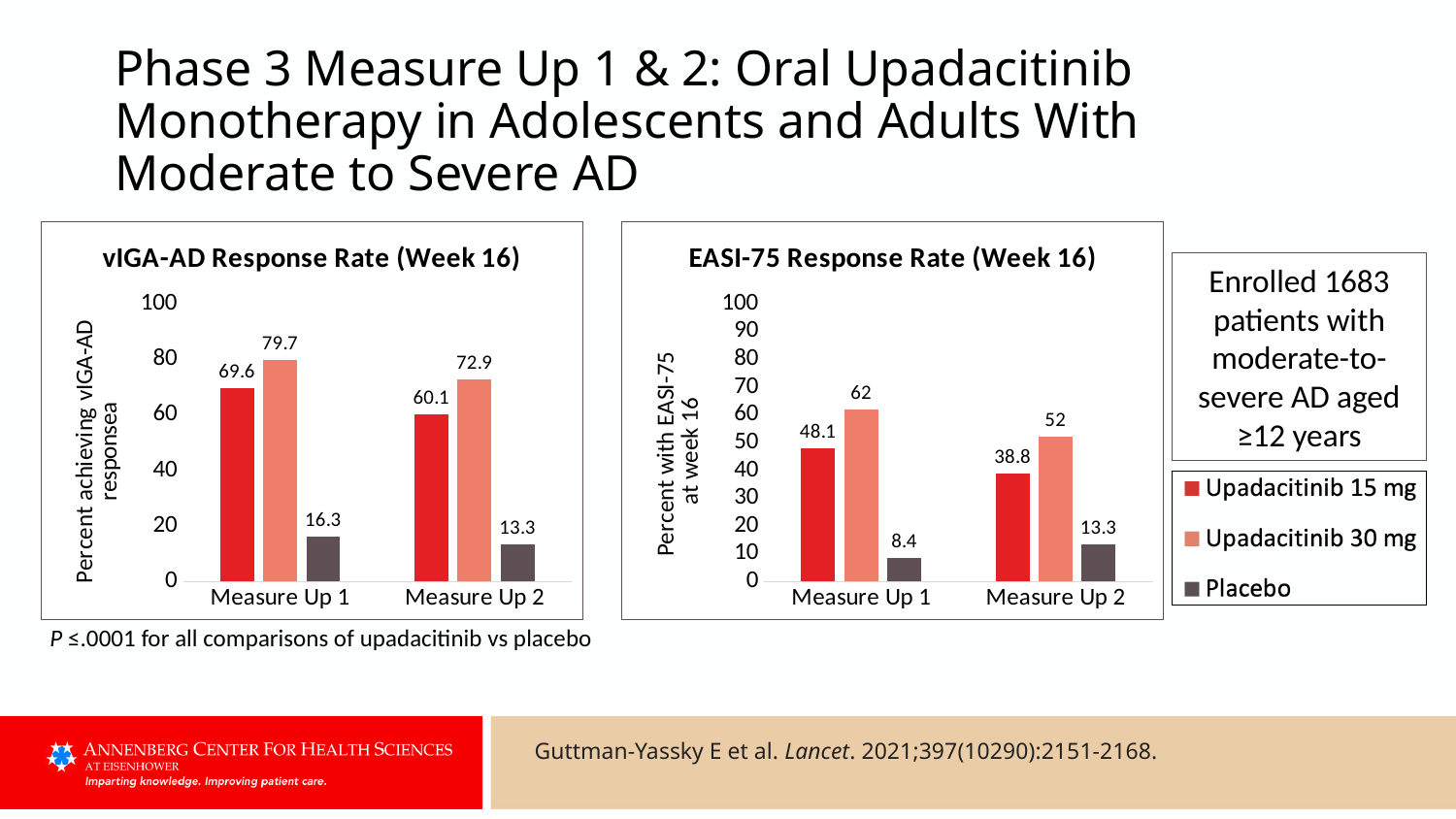
In the EASI-75 Response Rate (Week 16) chart, which series has the lowest value in Measure Up 2? Placebo In the EASI-75 Response Rate (Week 16) chart, what is the value for Placebo in Measure Up 1? 8.4 How many series does the legend list? 3 In the EASI-75 Response Rate (Week 16) chart, what is the difference between Upadacitinib 30 mg and Placebo in Measure Up 1? 53.6 In the EASI-75 Response Rate (Week 16) chart, what is the value for Upadacitinib 15 mg in Measure Up 2? 38.8 How many categories are shown on the x axis of the EASI-75 Response Rate (Week 16) chart? 2 In the vIGA-AD Response Rate (Week 16) chart, what is the value for Upadacitinib 30 mg in Measure Up 1? 79.7 What kind of chart is the vIGA-AD Response Rate (Week 16) chart? Bar chart In the vIGA-AD Response Rate (Week 16) chart, what is the difference between Upadacitinib 30 mg and Upadacitinib 15 mg in Measure Up 2? 12.8 In the EASI-75 Response Rate (Week 16) chart, which is larger: Upadacitinib 15 mg in Measure Up 1 or Upadacitinib 30 mg in Measure Up 2? Upadacitinib 30 mg in Measure Up 2 In the vIGA-AD Response Rate (Week 16) chart, what is the value for Placebo in Measure Up 2? 13.3 In the vIGA-AD Response Rate (Week 16) chart, which series has the highest value in Measure Up 1? Upadacitinib 30 mg